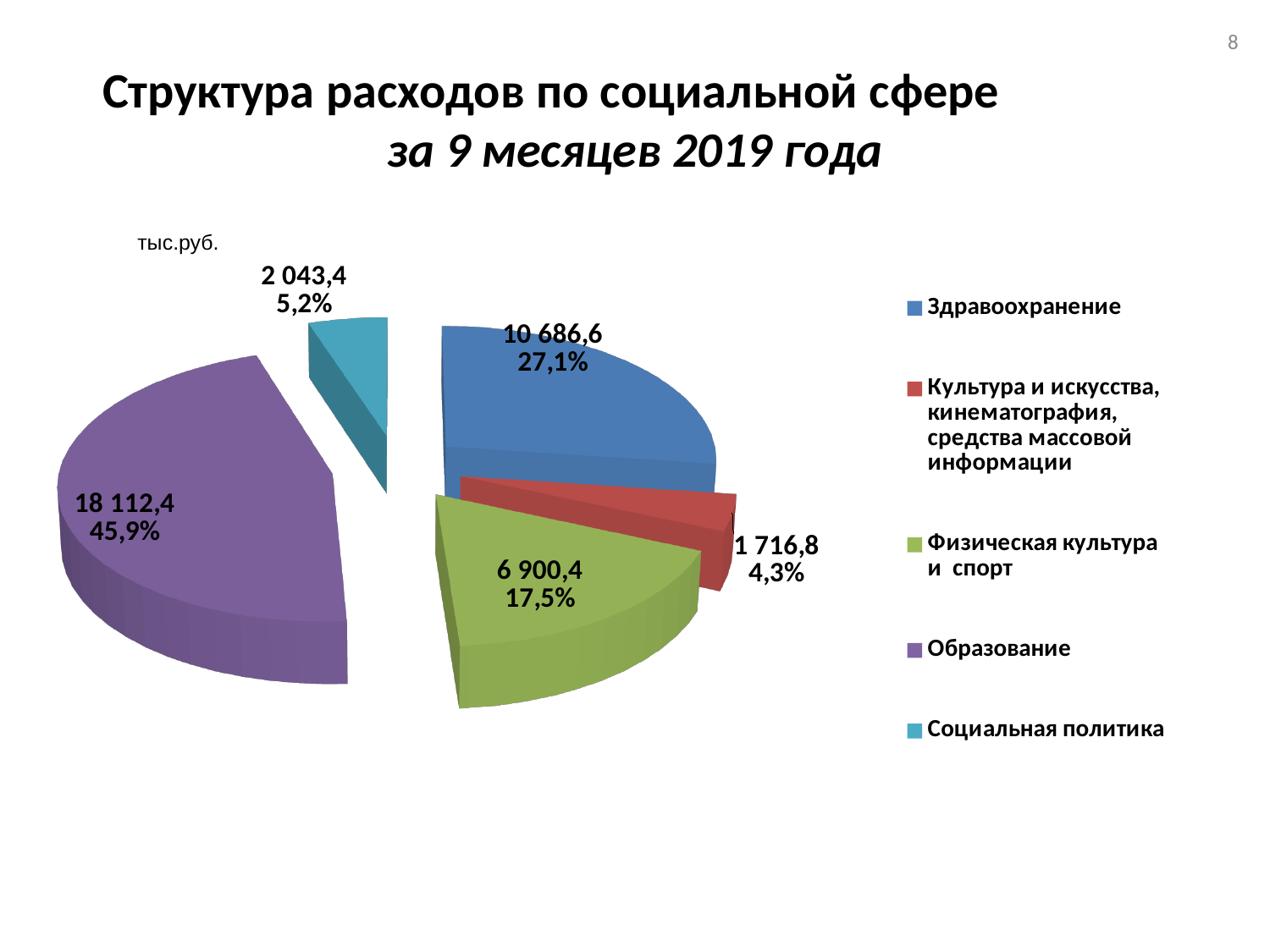
What kind of chart is shown on the slide? Pie chart How many entries does the legend list? 5 What is the difference between the percentage shares of Образование and Здравоохранение? 18,8% What percentage share is shown for Социальная политика? 5,2% Which is larger: the value for Здравоохранение or the value for Физическая культура и спорт? Здравоохранение Which category has the largest share of the pie? Образование How many slices does the pie chart have? 5 What unit is indicated for the values on the chart? тыс.руб. Which category has the smallest share of the pie? Культура и искусства, кинематография, средства массовой информации What percentage share is shown for Здравоохранение? 27,1% What is the value shown for Образование? 18 112,4 What is the value shown for Физическая культура и спорт? 6 900,4